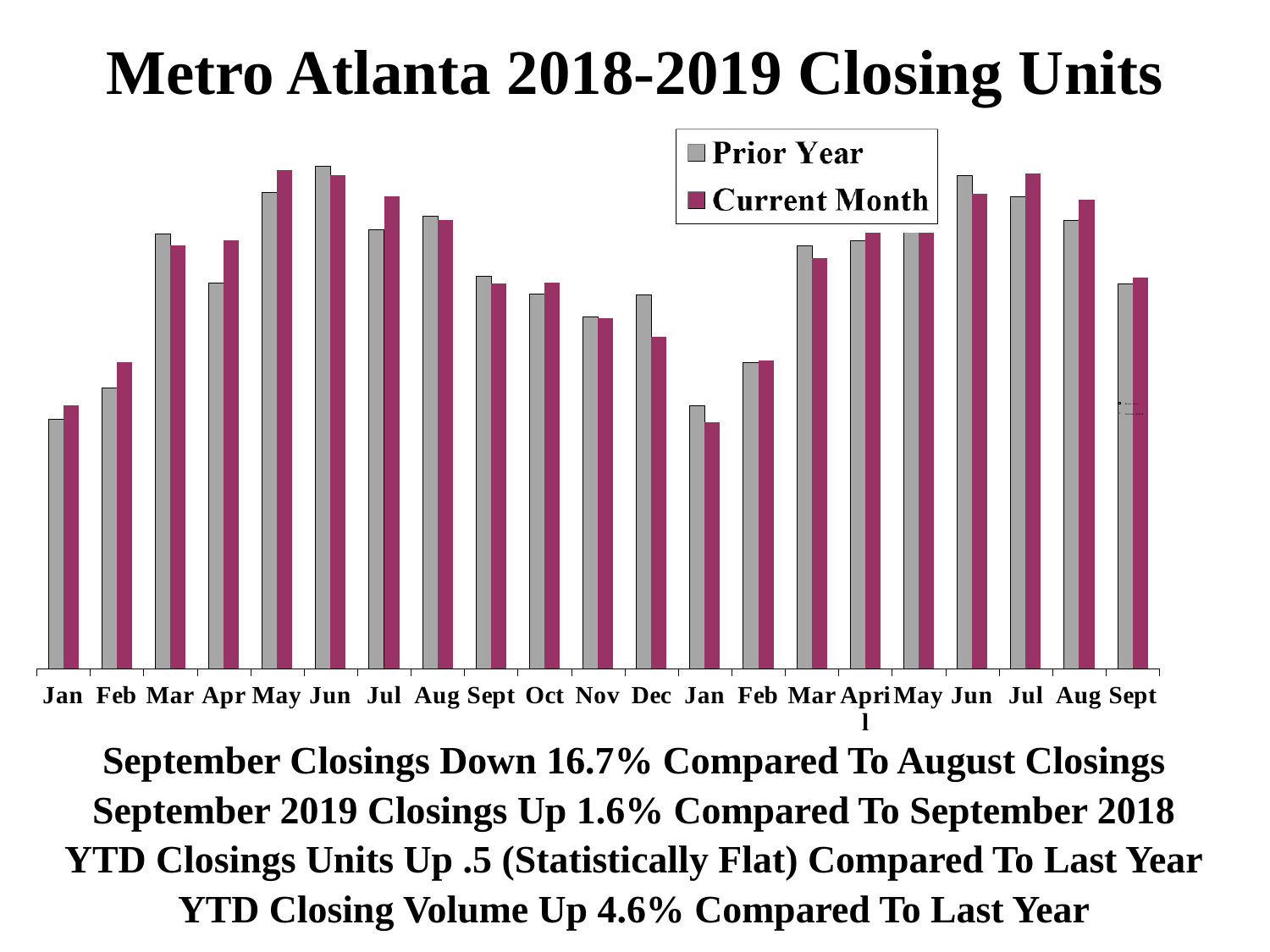
In which month is the Prior Year bar the tallest? the first Jun What is the title of the chart? Metro Atlanta 2018-2019 Closing Units How many series does the legend list? 2 In the first Apr, which is larger: the Prior Year bar or the Current Month bar? Current Month In Dec, which is larger: the Prior Year bar or the Current Month bar? Prior Year How many month categories are shown along the x axis? 21 Do the Prior Year bars rise or fall from the first Jan to the first Jun? rise Do the Current Month bars rise or fall from the first Jun to Nov? fall In which month is the Current Month bar the shortest? the second Jan What kind of chart is shown on the slide? bar chart In the second Jun, which is larger: the Prior Year bar or the Current Month bar? Prior Year Which series is shown in gray in the legend? Prior Year